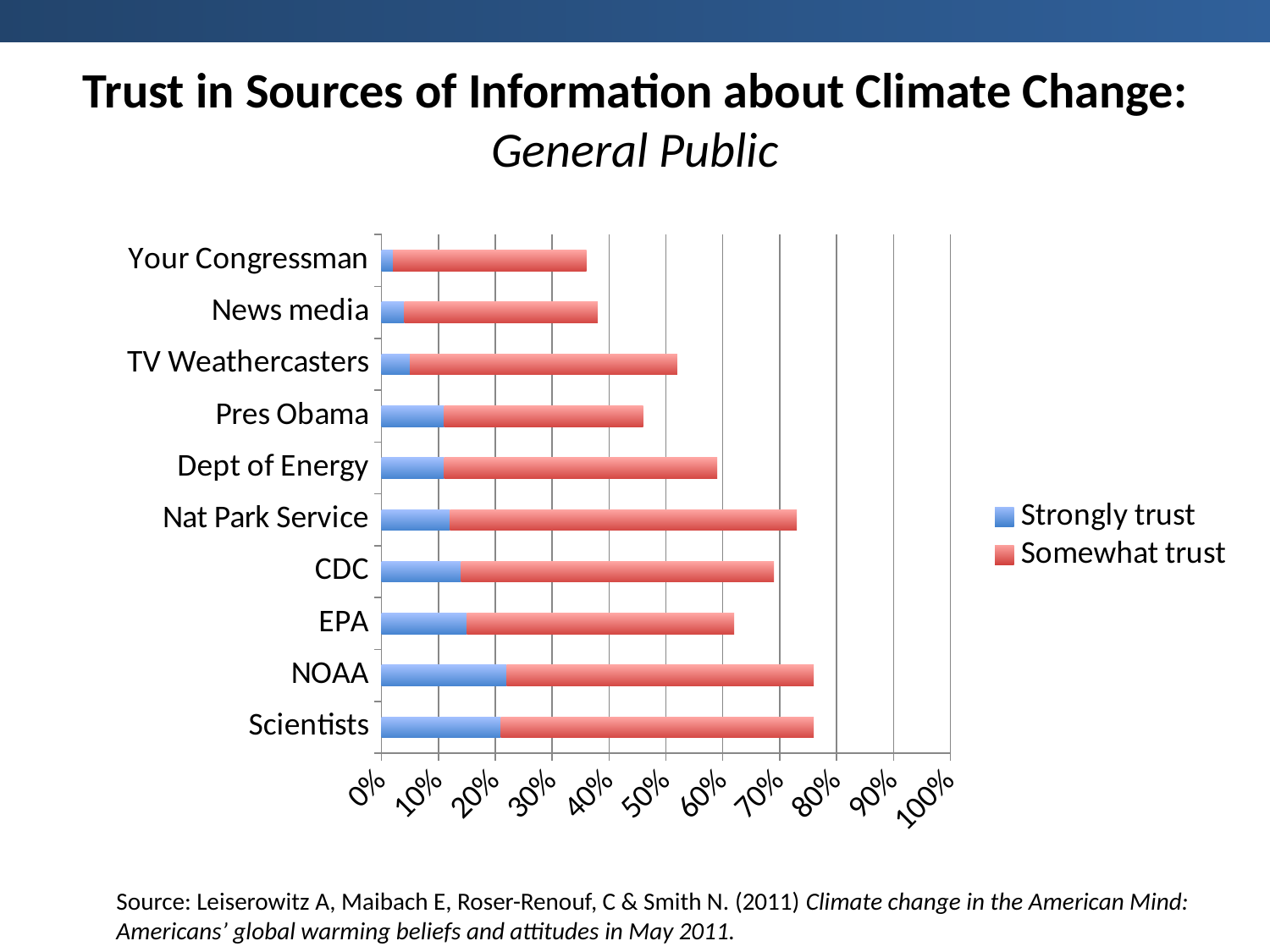
What kind of chart is shown on the slide? bar chart What are the two series named in the legend? Strongly trust, Somewhat trust Is the total trust (strongly plus somewhat) for Nat Park Service greater or less than 70%? greater Is the total trust (strongly plus somewhat) for CDC greater or less than 60%? greater How many series does the legend list? 2 Which has a larger total trust bar, Dept of Energy or Pres Obama? Dept of Energy Is the 'Strongly trust' value for Scientists greater or less than 10%? greater Which has a larger total trust bar, Nat Park Service or CDC? Nat Park Service How many sources of information are listed on the chart? 10 Which colour represents 'Strongly trust' in the chart? blue